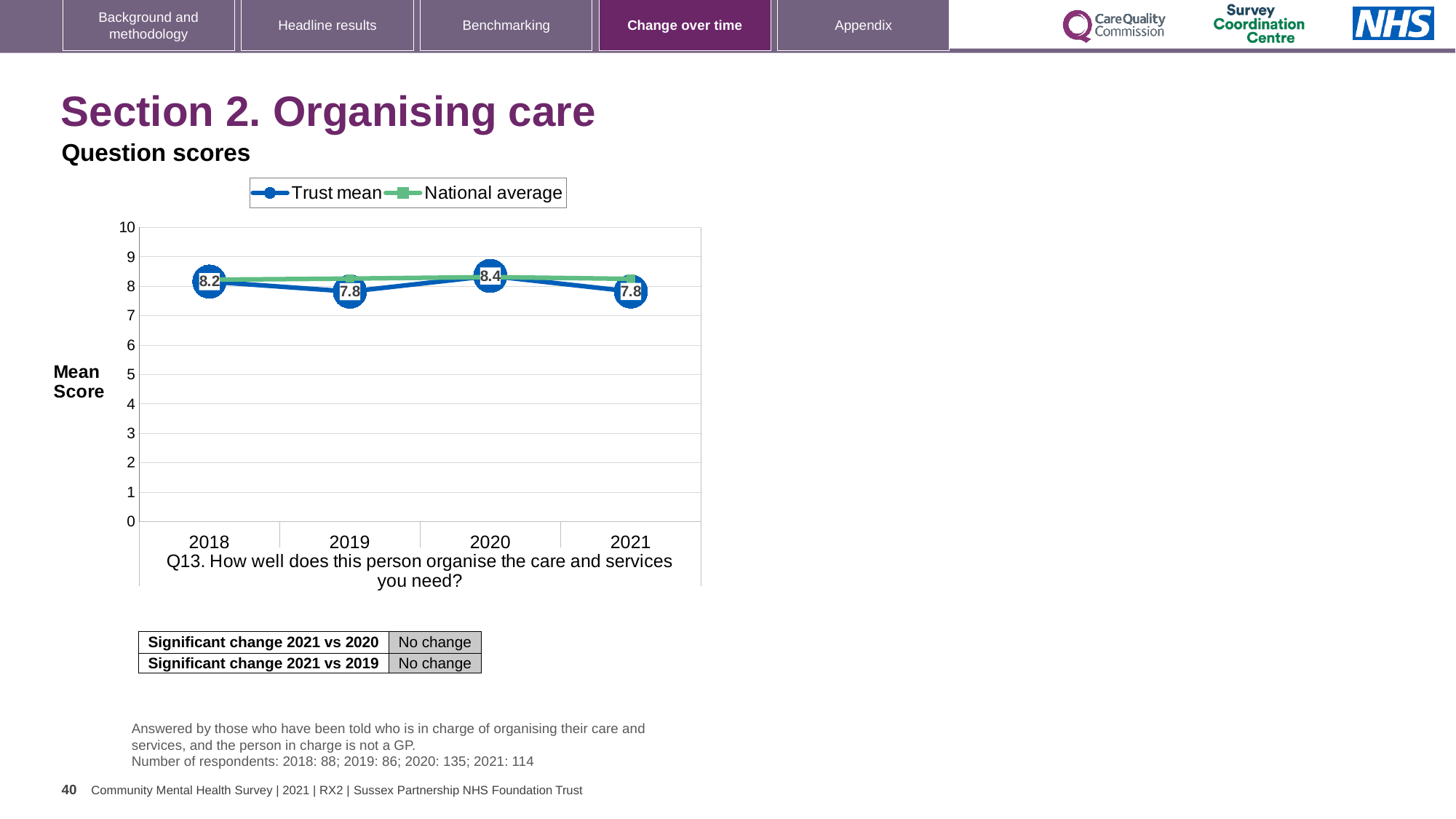
How many series does the chart legend list? 2 What is the Trust mean score for 2018? 8.2 Does the Trust mean score rise or fall from 2020 to 2021? fall What is the difference between the Trust mean scores for 2020 and 2019? 0.6 What is the Trust mean score for 2021? 7.8 Is the National average value for 2018 greater or less than 7? greater How many years are shown on the x axis of the chart? 4 What is the difference between the Trust mean scores for 2018 and 2019? 0.4 In which year is the Trust mean score highest? 2020 What is the Trust mean score for 2020? 8.4 What kind of chart is shown on the slide? line chart Which is larger, the Trust mean score for 2018 or for 2019? 2018